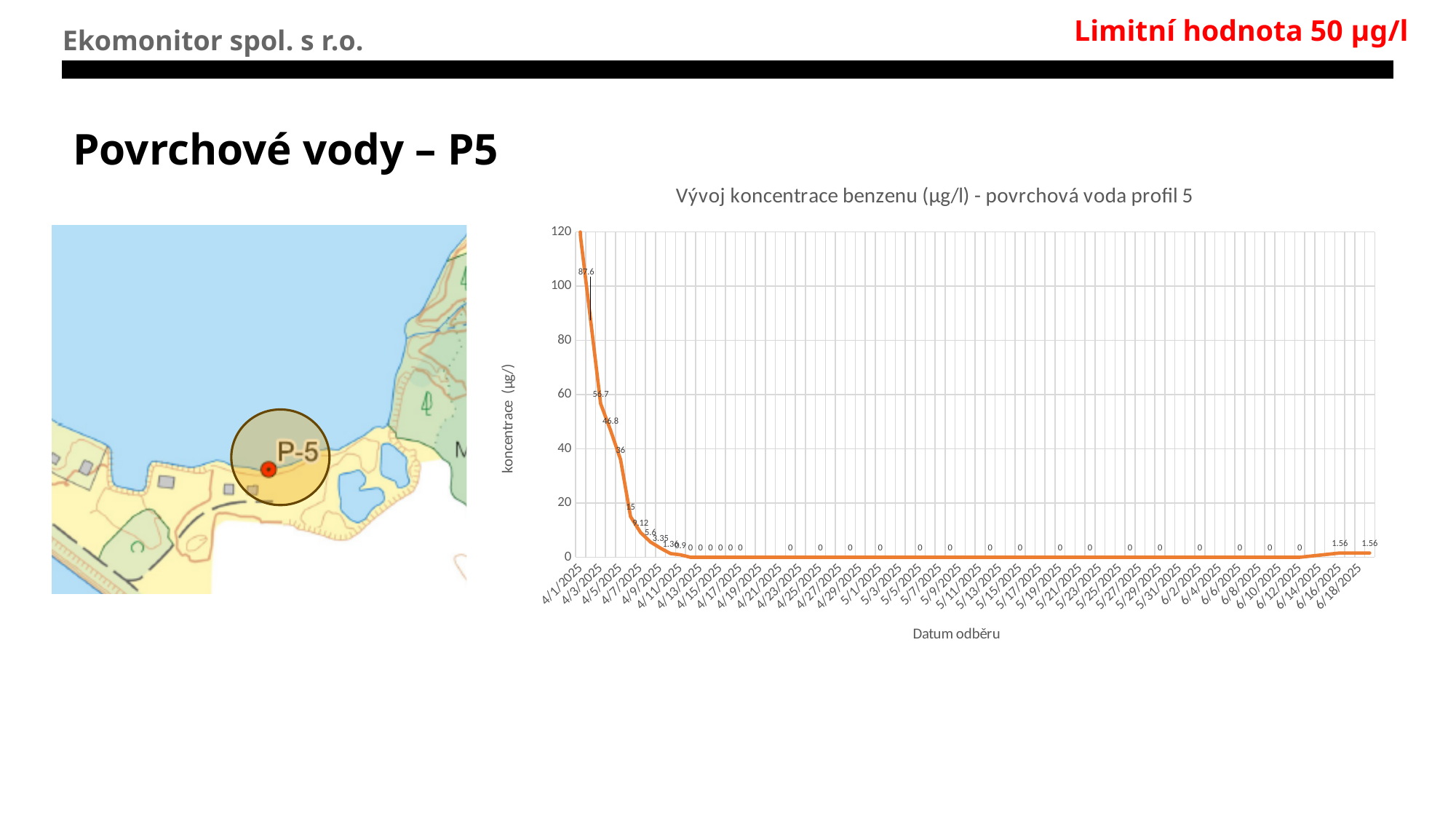
What kind of chart is shown on the slide? line chart What is the title of the chart? Vývoj koncentrace benzenu (µg/l) - povrchová voda profil 5 Which is larger, the data label 87.6 or the data label 56.7? 87.6 What is the last data label shown at the right end of the line? 1.56 What is the label of the x axis of the chart? Datum odběru Is the value plotted at 5/1/2025 greater or less than 20? less What is the highest value printed as a data label on the line? 87.6 Do the plotted concentration values generally rise or fall from left to right along the x axis? fall What is the difference between the data labels 46.8 and 36? 10.8 What is the difference between the data labels 87.6 and 56.7? 30.9 What is the lowest value printed as a data label on the line? 0 Is the value plotted at 4/1/2025 greater or less than 100? greater